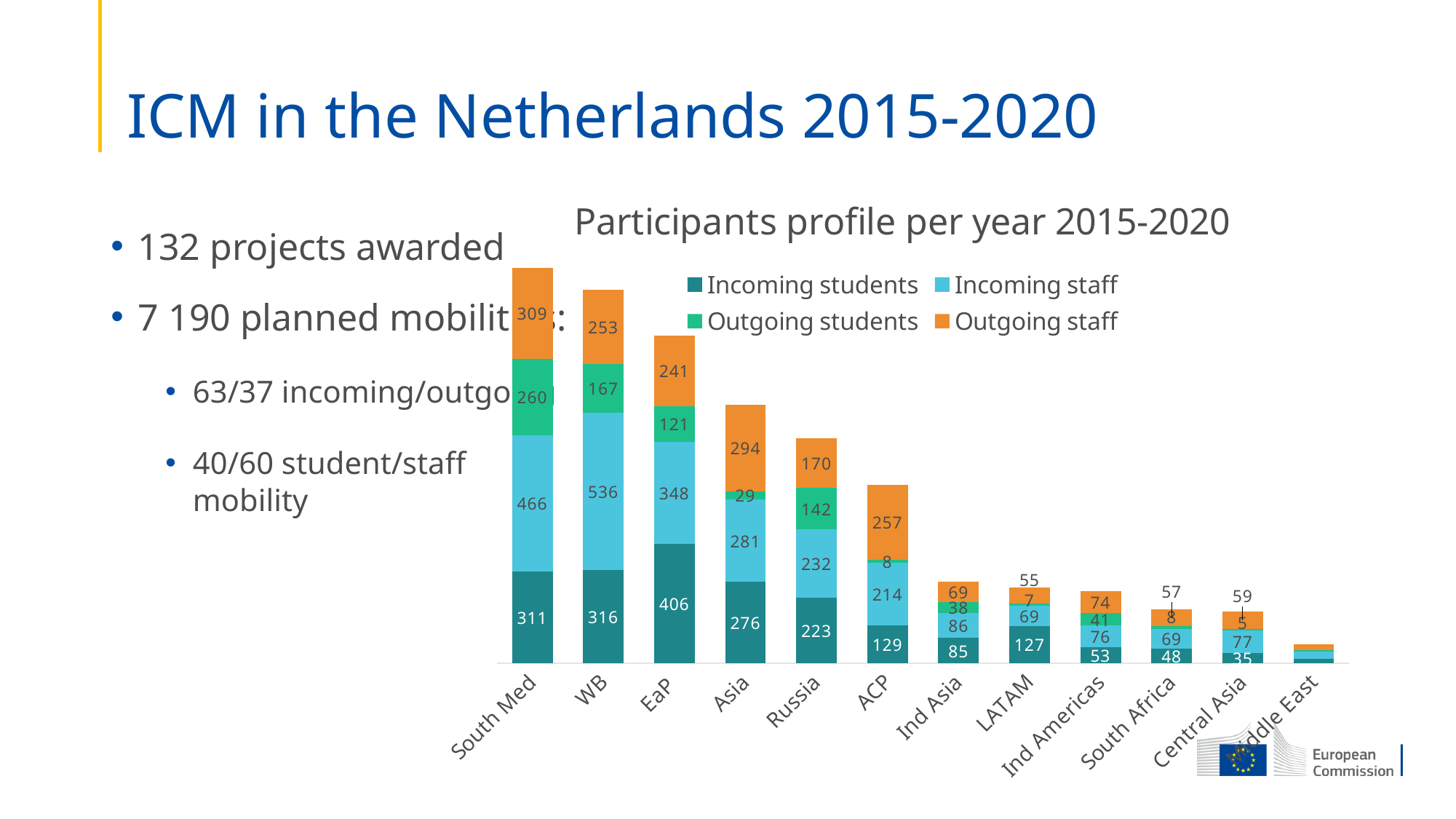
How many series does the legend of the chart list? 4 What kind of chart is shown on the slide? Stacked bar chart Which has the larger Incoming staff value, South Med or EaP? South Med Which category has the highest Incoming students value? EaP What is the title of the chart? Participants profile per year 2015-2020 Which category has the tallest stacked bar overall? South Med What is the Outgoing students value for Asia? 29 What is the difference between the Outgoing students values for South Med and WB? 93 What is the Outgoing staff value for ACP? 257 What is the Incoming staff value for WB? 536 How many categories are shown along the x axis of the chart? 12 What is the total of the stacked bar for South Med? 1346